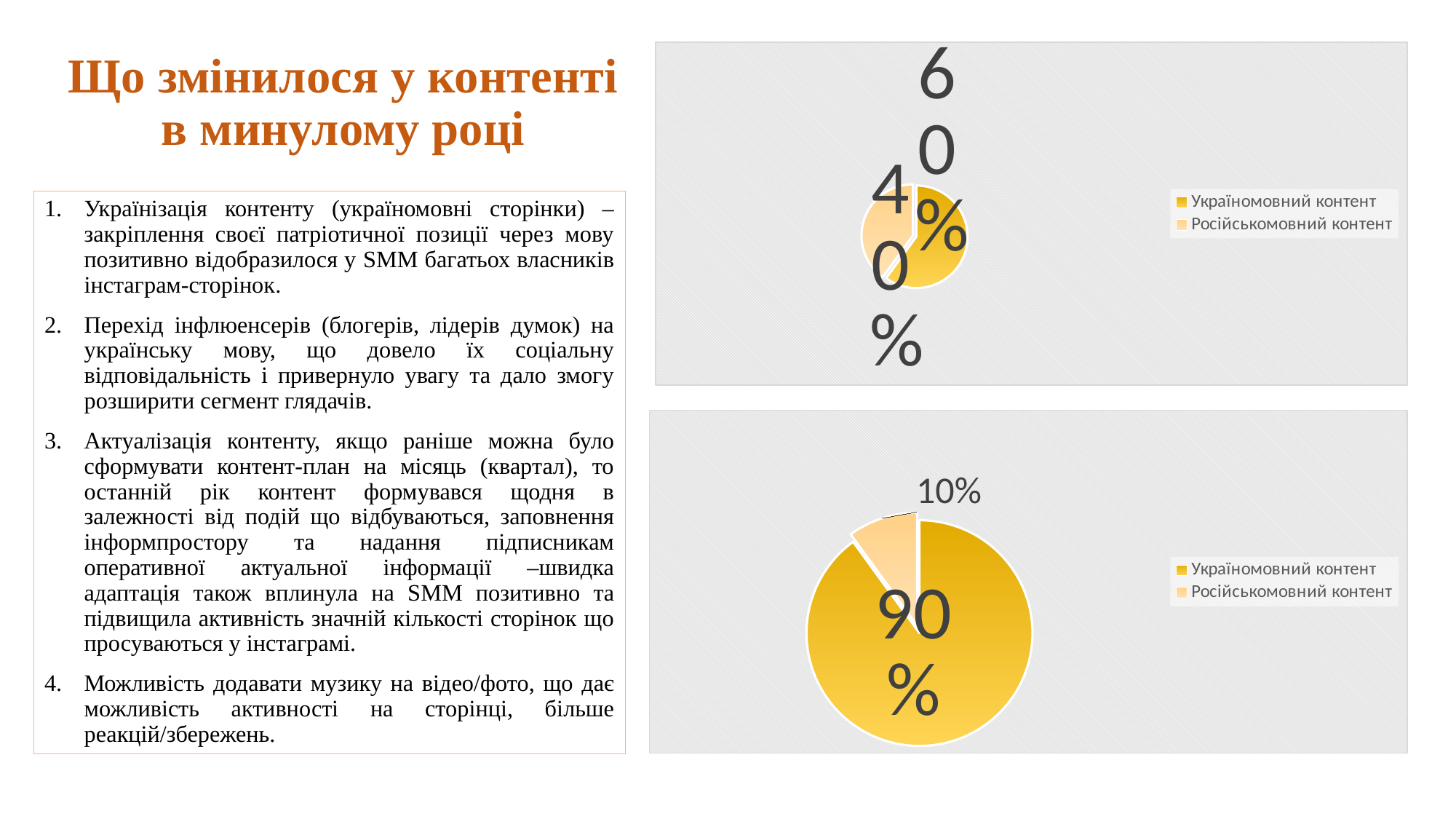
In the bottom pie chart, which category has the largest slice? Україномовний контент In the bottom pie chart, which colour represents Російськомовний контент? Light yellow What type of chart is the bottom chart on the slide? Pie chart In the top pie chart, which is larger: Україномовний контент or Російськомовний контент? Україномовний контент How many categories does the legend of the bottom chart list? 2 In the top pie chart, which category has the smallest slice? Російськомовний контент In the bottom pie chart, what share does Російськомовний контент have? 10% In the bottom pie chart, what share does Україномовний контент have? 90% In the top pie chart, what share does Україномовний контент have? 60% In the top pie chart, what is the difference between the shares of Україномовний контент and Російськомовний контент? 20% In the top pie chart, what share does Російськомовний контент have? 40% In the bottom pie chart, what is the difference between the shares of Україномовний контент and Російськомовний контент? 80%